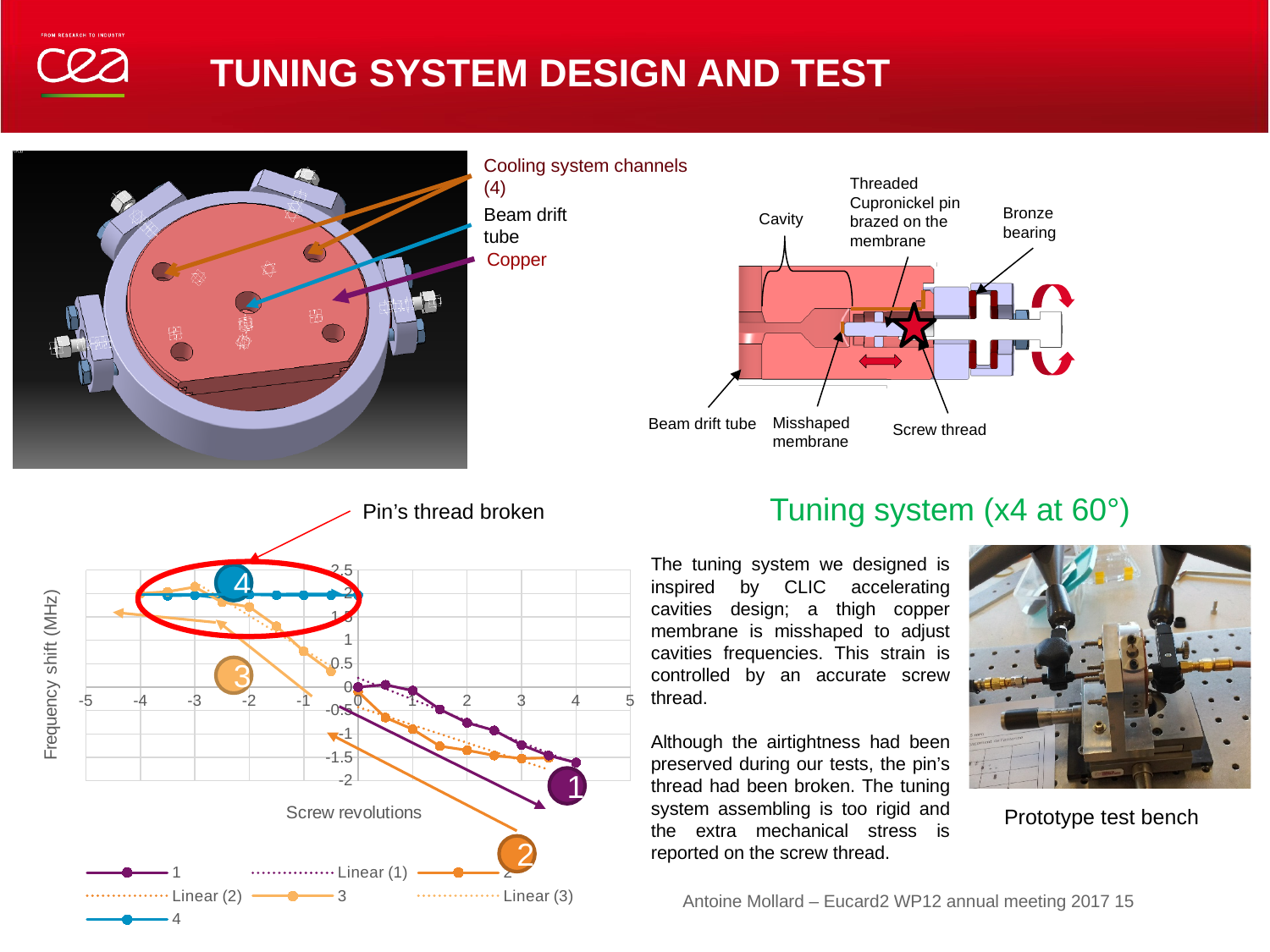
Does the frequency shift for series 1 rise or fall as screw revolutions increase from 0 to 4? fall How many entries does the chart legend list? 7 What is the label of the chart's y axis? Frequency shift (MHz) Is the value of series 4 at 0 screw revolutions greater or less than 1? greater At 0 screw revolutions, which series has the larger frequency shift, series 1 or series 4? series 4 Which series reaches the highest frequency shift on the chart? 3 Is the value of series 1 at 1 screw revolutions greater or less than 1? less Is the value of series 1 at 4 screw revolutions greater or less than -1? less What is the label of the chart's x axis? Screw revolutions Does the frequency shift for series 2 rise or fall as screw revolutions increase from 0 to 4? fall What type of chart is shown on the slide? line chart